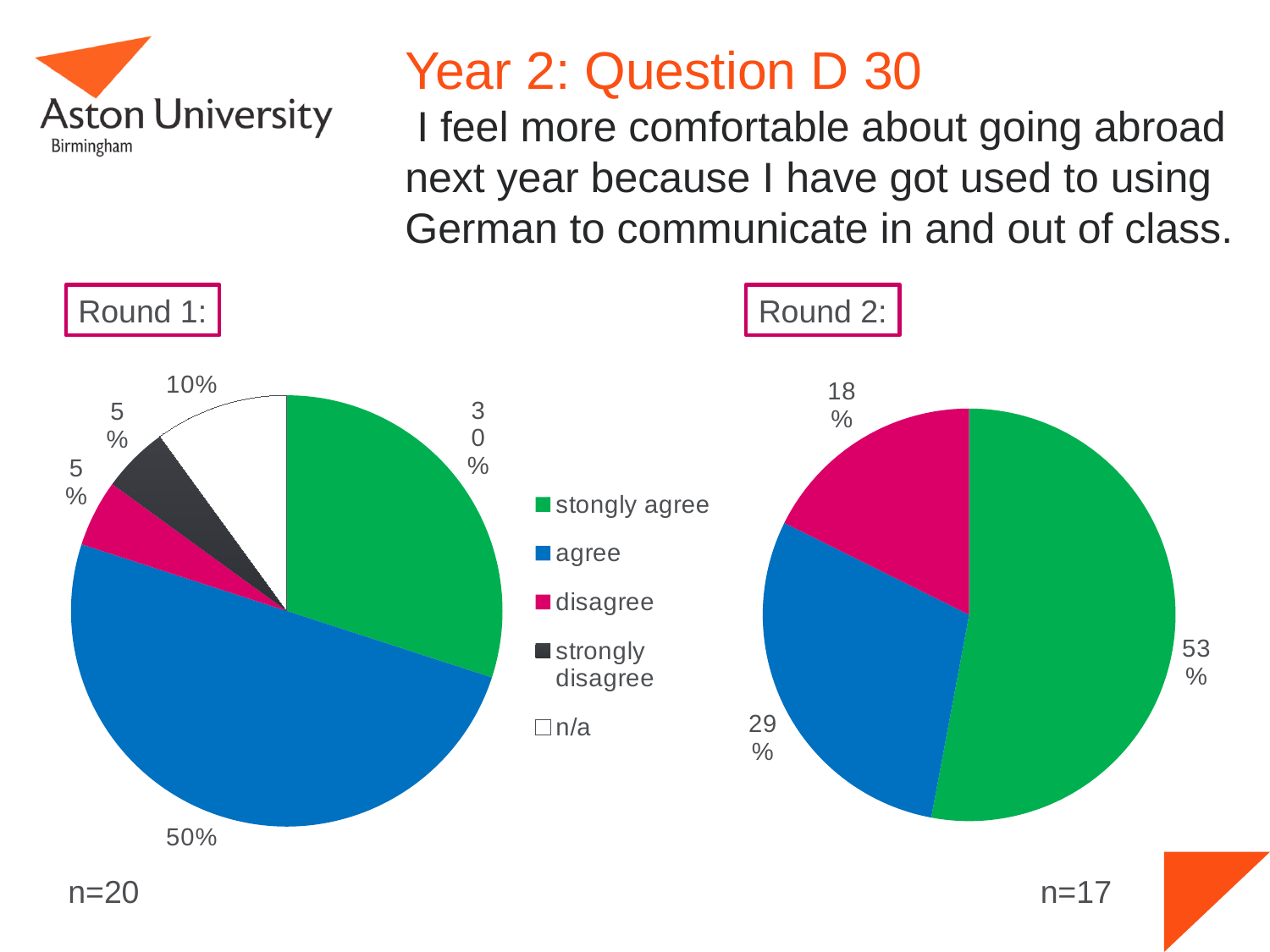
In the Round 1 pie chart, what share of respondents chose 'agree'? 50% What is the difference between the 'agree' share in Round 1 and the 'agree' share in Round 2? 21% In the Round 2 pie chart, which response has the smallest share? disagree In the Round 2 pie chart, what share of respondents chose 'disagree'? 18% How many slices does the Round 2 pie chart have? 3 In the Round 1 pie chart, what share of respondents answered 'n/a'? 10% In the Round 1 pie chart, what share of respondents chose 'strongly agree'? 30% In the Round 2 pie chart, which response has the largest share? strongly agree What kind of chart is used for Round 1? pie chart How many entries does the legend list? 5 In the Round 1 pie chart, which response has the largest share? agree In the Round 2 pie chart, what share of respondents chose 'strongly agree'? 53%